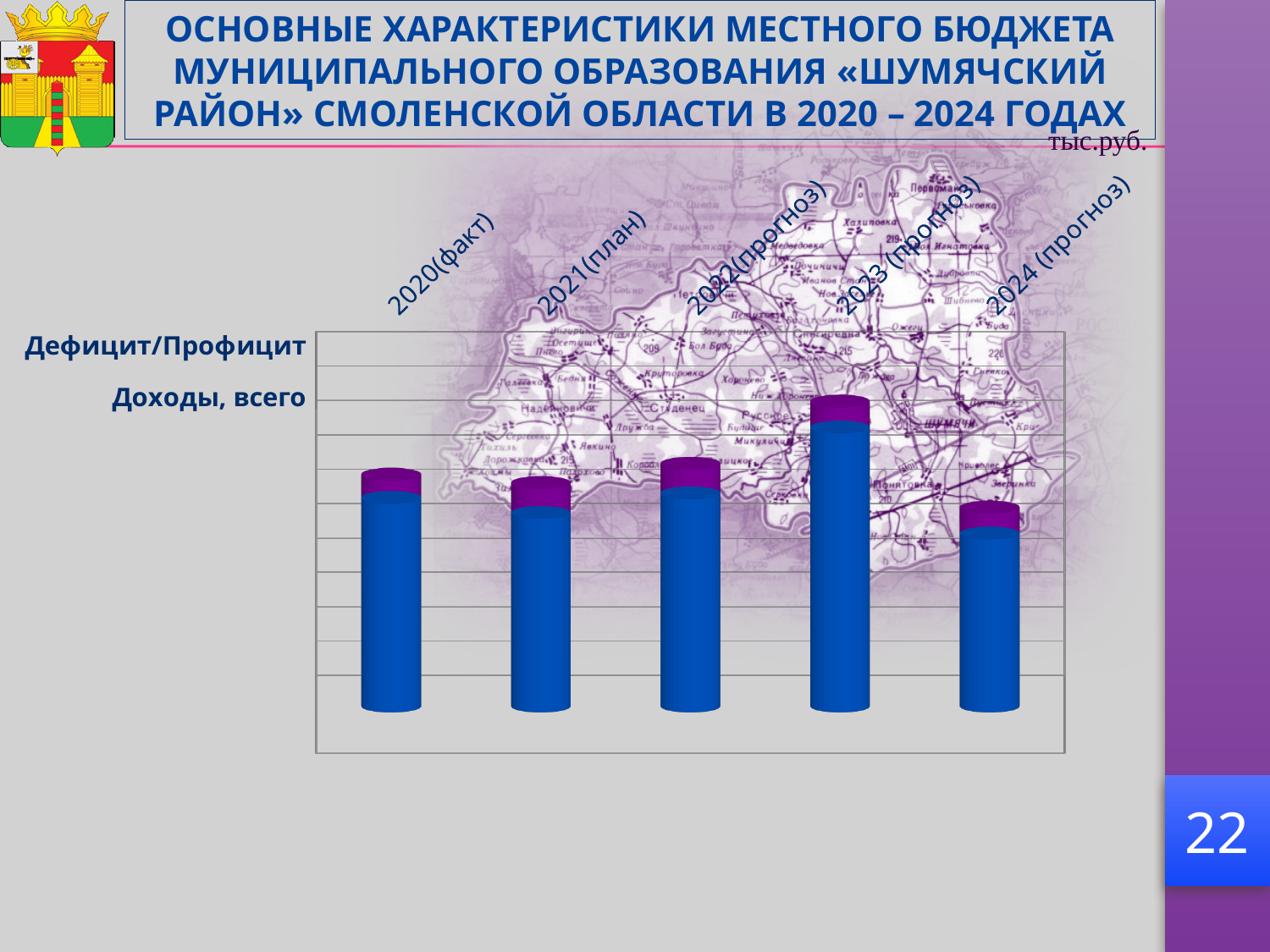
Which bar is taller: 2021(план) or 2024 (прогноз)? 2021(план) Which year category has the shortest bar in the chart? 2024 (прогноз) In what units are the chart values given, according to the label above the chart? тыс.руб. Which year category has the tallest bar in the chart? 2023 (прогноз) How many year categories are shown along the x axis of the chart? 5 What kind of chart is shown on the slide? Bar chart Which bar is taller: 2022(прогноз) or 2020(факт)? 2022(прогноз) Which bar is taller: 2023 (прогноз) or 2024 (прогноз)? 2023 (прогноз)